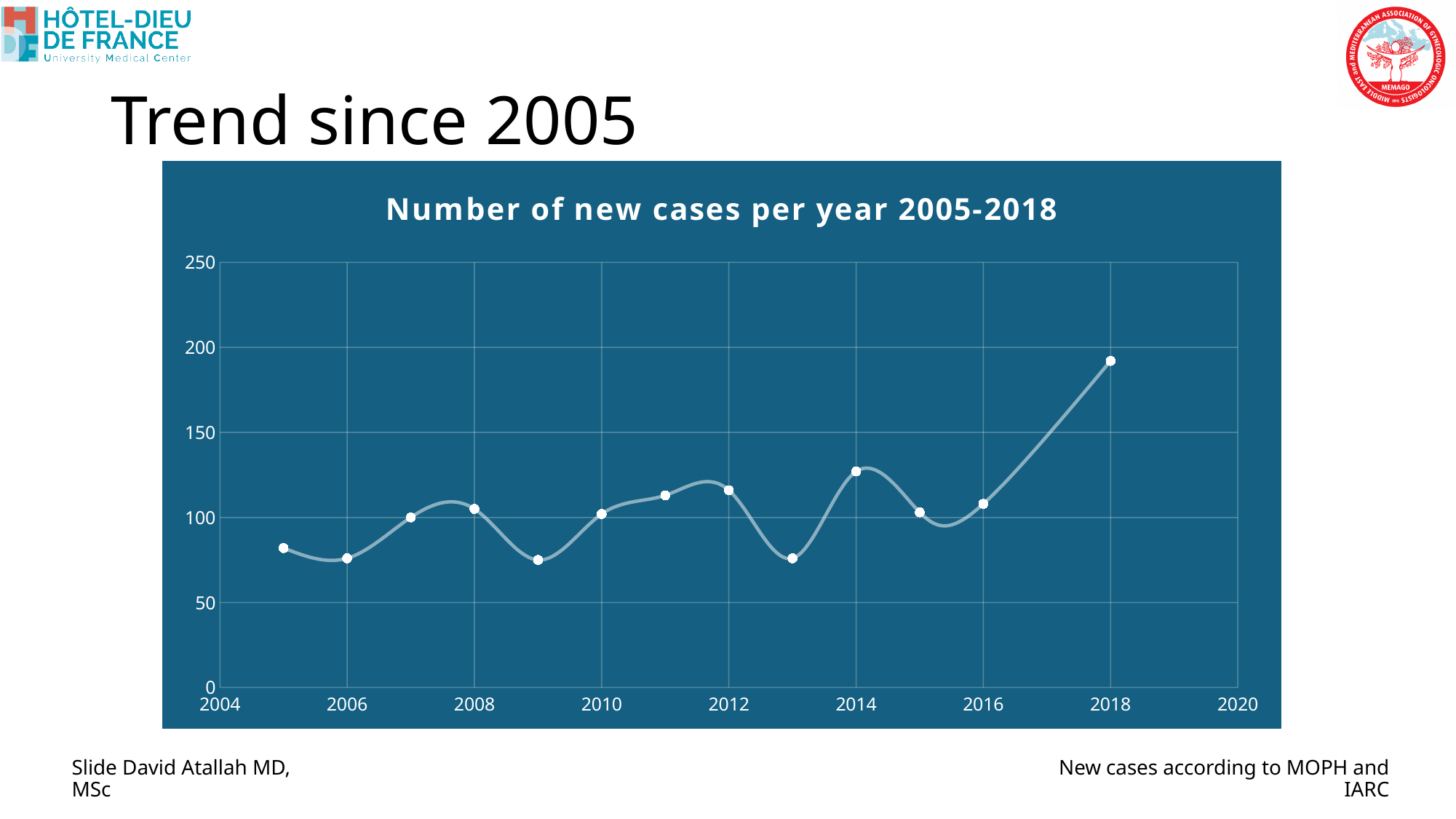
Which year has the highest number of new cases? 2018 Is the value for 2018 greater or less than 200? less Is the value for 2018 greater or less than 150? greater Overall, do the number of new cases rise or fall from 2005 to 2018? rise Is the value for 2009 greater or less than 100? less What kind of chart is shown on the slide? line chart Which year has more new cases, 2018 or 2014? 2018 What is the title of the chart? Number of new cases per year 2005-2018 Which year has more new cases, 2014 or 2013? 2014